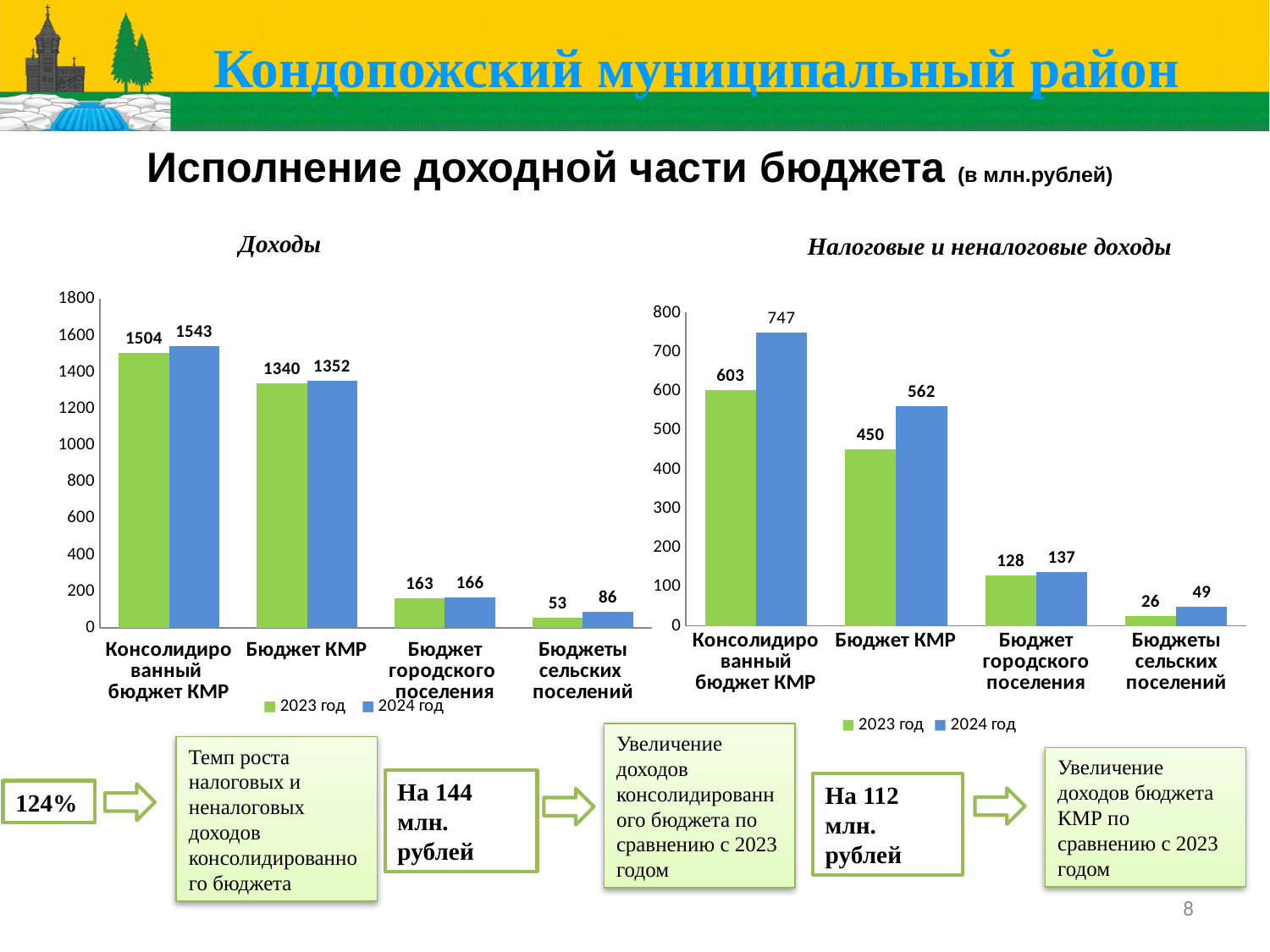
In the "Налоговые и неналоговые доходы" chart, which category has the highest value in 2024 год? Консолидированный бюджет КМР In the "Доходы" chart, what is the value for Консолидированный бюджет КМР in 2024 год? 1543 In the "Доходы" chart, what is the value for Бюджеты сельских поселений in 2023 год? 53 In the "Налоговые и неналоговые доходы" chart, what is the difference between the 2024 год and 2023 год values for Консолидированный бюджет КМР? 144 In the "Доходы" chart, what is the difference between the 2024 год and 2023 год values for Бюджеты сельских поселений? 33 In the "Налоговые и неналоговые доходы" chart, what is the value for Бюджет КМР in 2024 год? 562 In the "Доходы" chart, which category has the lowest value in 2023 год? Бюджеты сельских поселений In the "Доходы" chart, which is larger for Бюджет КМР: the 2023 год value or the 2024 год value? 2024 год What kind of chart is the "Налоговые и неналоговые доходы" chart? Bar chart How many series does the legend of the "Доходы" chart list? 2 In the "Налоговые и неналоговые доходы" chart, what is the value for Бюджет городского поселения in 2023 год? 128 How many categories are shown on the x axis of the "Налоговые и неналоговые доходы" chart? 4